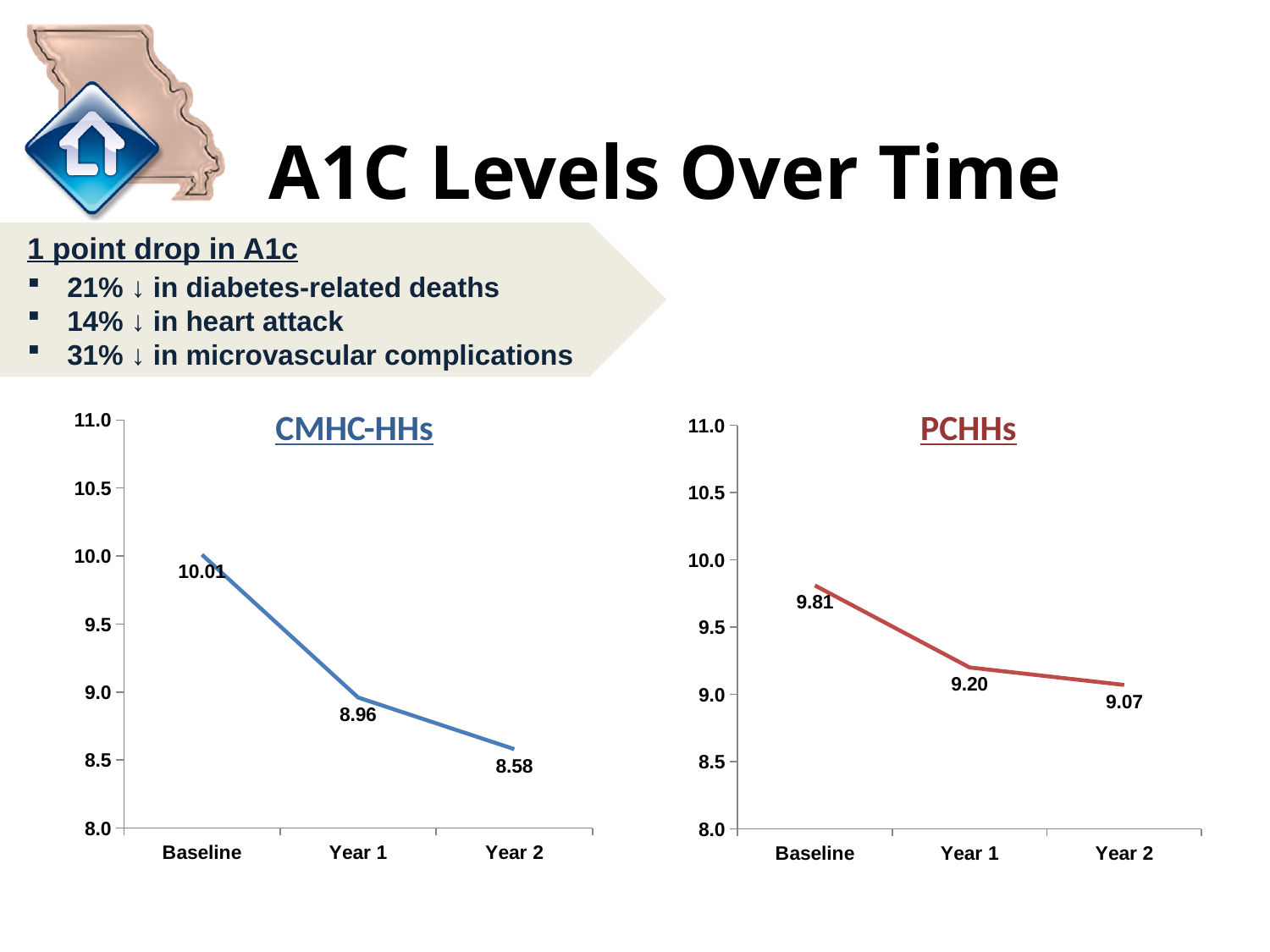
In the CMHC-HHs chart, what is the A1C value at Baseline? 10.01 In the CMHC-HHs chart, what is the difference between the Baseline and Year 2 values? 1.43 In the CMHC-HHs chart, what is the A1C value at Year 2? 8.58 In the PCHHs chart, what is the A1C value at Year 2? 9.07 In the PCHHs chart, what is the difference between the Baseline and Year 1 values? 0.61 In the PCHHs chart, which time point has the lowest A1C value? Year 2 In the CMHC-HHs chart, how many time points are plotted? 3 In the PCHHs chart, do the values rise or fall from Baseline to Year 2? Fall In the PCHHs chart, what is the A1C value at Year 1? 9.20 In the CMHC-HHs chart, which time point has the highest A1C value? Baseline Which is larger: the Year 1 value in the CMHC-HHs chart or the Year 1 value in the PCHHs chart? PCHHs What type of chart is the PCHHs chart? Line chart